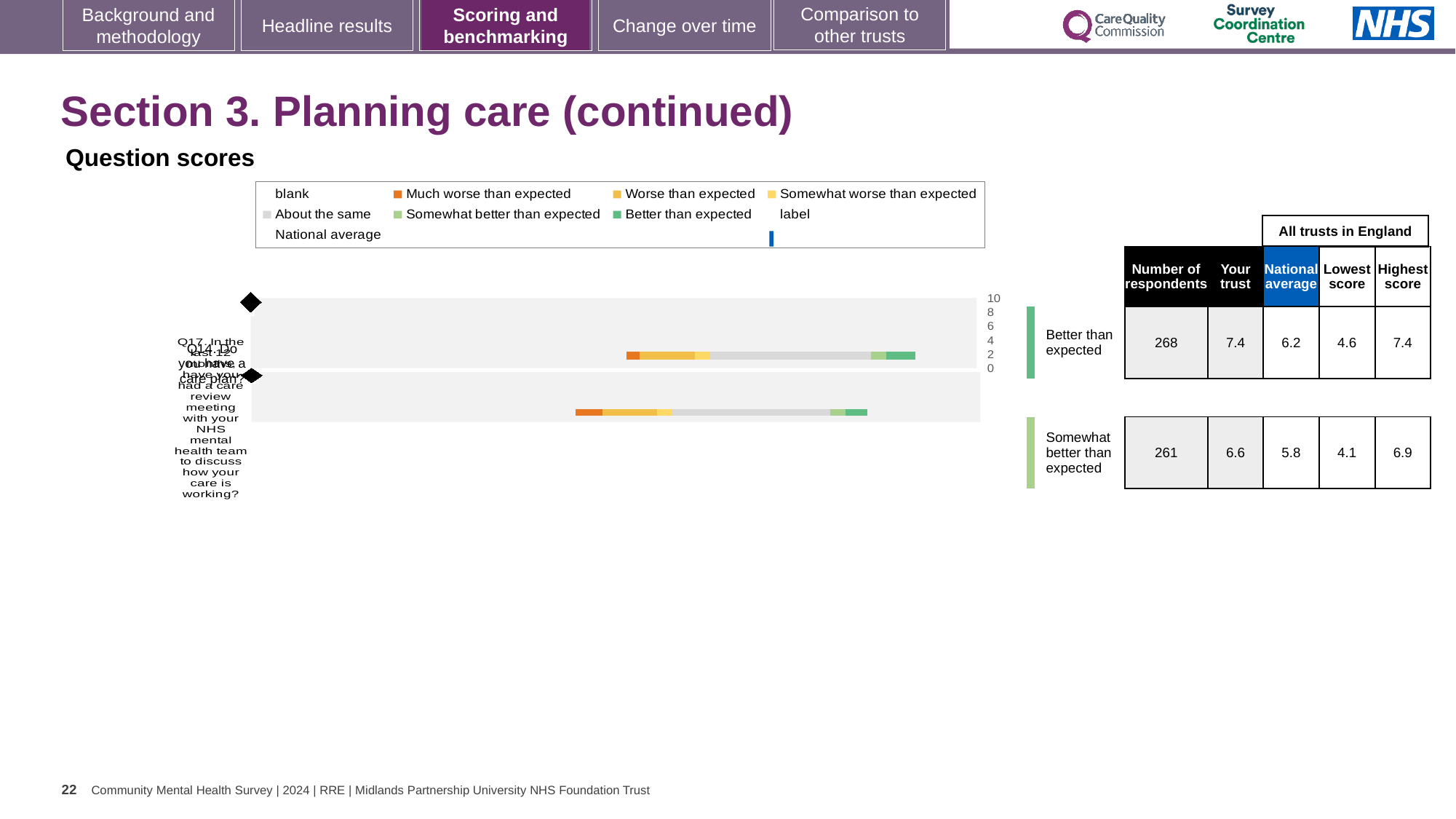
Which question has the higher 'Your trust' score: the one rated 'Better than expected' or the one rated 'Somewhat better than expected'? Better than expected What is the maximum value shown on the chart's score axis? 10 What is the highest score across all trusts in England for the question rated 'Better than expected'? 7.4 What kind of chart is shown under 'Question scores'? bar chart What is the difference between the trust score and the national average for the question rated 'Better than expected'? 1.2 How many question bars are plotted in the chart? 2 What is the lowest score across all trusts in England for the question rated 'Somewhat better than expected'? 4.1 How many respondents answered the question rated 'Better than expected'? 268 What is the 'Your trust' score for the question rated 'Better than expected'? 7.4 What is the 'Your trust' score for the question rated 'Somewhat better than expected'? 6.6 What is the national average for the question rated 'Better than expected'? 6.2 What is the national average for the question rated 'Somewhat better than expected'? 5.8